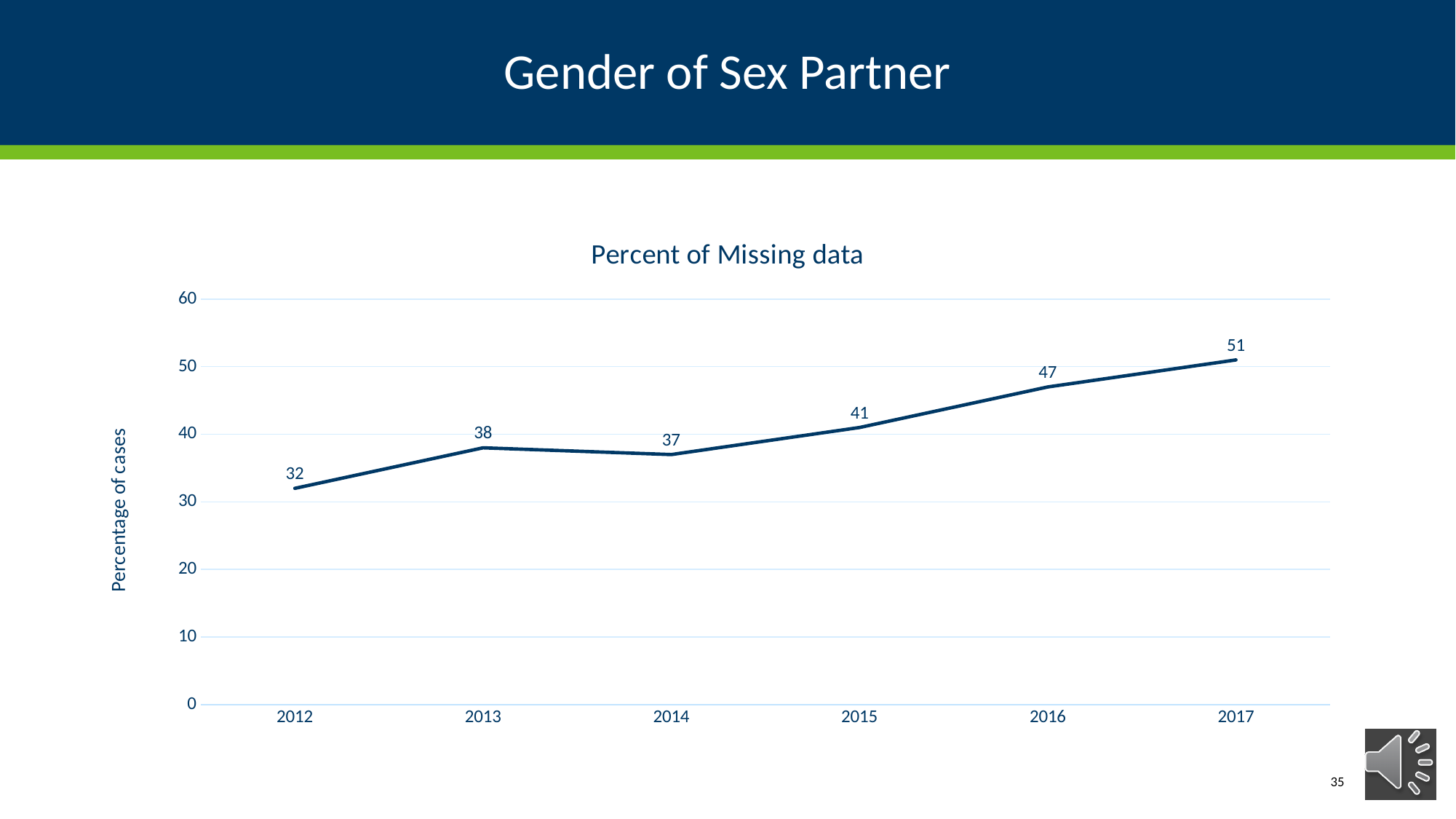
What is the difference between the percent of missing data in 2017 and in 2012? 19 Does the percent of missing data generally rise or fall from 2012 to 2017? Rise Which year has a higher percent of missing data, 2013 or 2014? 2013 What is the percent of missing data in 2012? 32 What is the percent of missing data in 2014? 37 What kind of chart is shown on the slide? Line chart Which year has the highest percent of missing data? 2017 What is the percent of missing data in 2017? 51 What is the title of the chart? Percent of Missing data How many years are plotted on the chart? 6 Which year has the lowest percent of missing data? 2012 What is the difference between the percent of missing data in 2016 and in 2015? 6